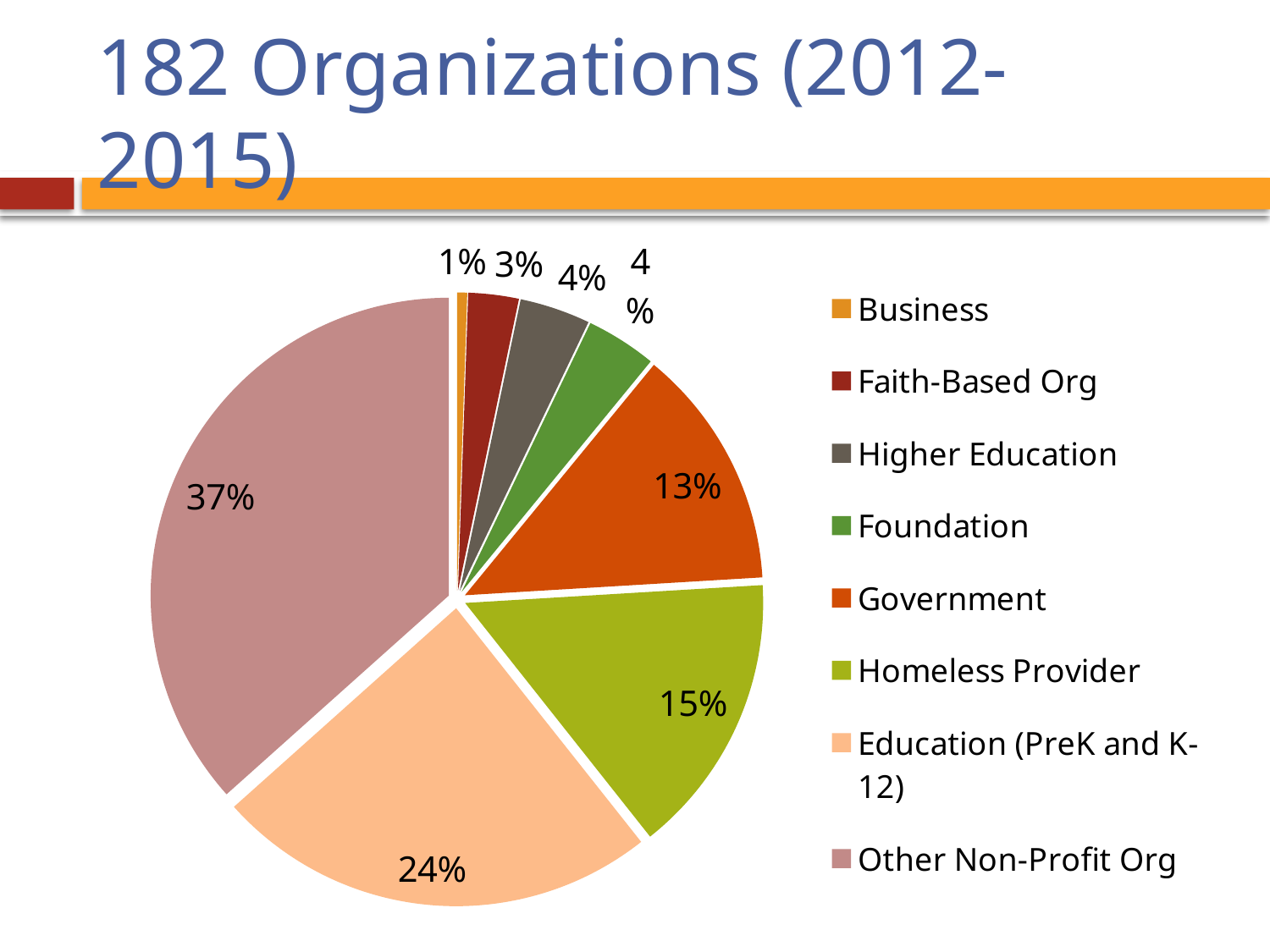
What share of the pie does Other Non-Profit Org have? 37% What is the value shown for Government? 13% Which category has the smallest slice of the pie? Business What is the difference between the shares for Other Non-Profit Org and Education (PreK and K-12)? 13% What is the value shown for Homeless Provider? 15% Which category has the largest slice of the pie? Other Non-Profit Org Which is larger, the share for Homeless Provider or the share for Government? Homeless Provider What is the value shown for Business? 1% What kind of chart is shown on the slide? pie chart How many categories does the legend list? 8 What is the value shown for Faith-Based Org? 3% What share of the pie does Education (PreK and K-12) have? 24%